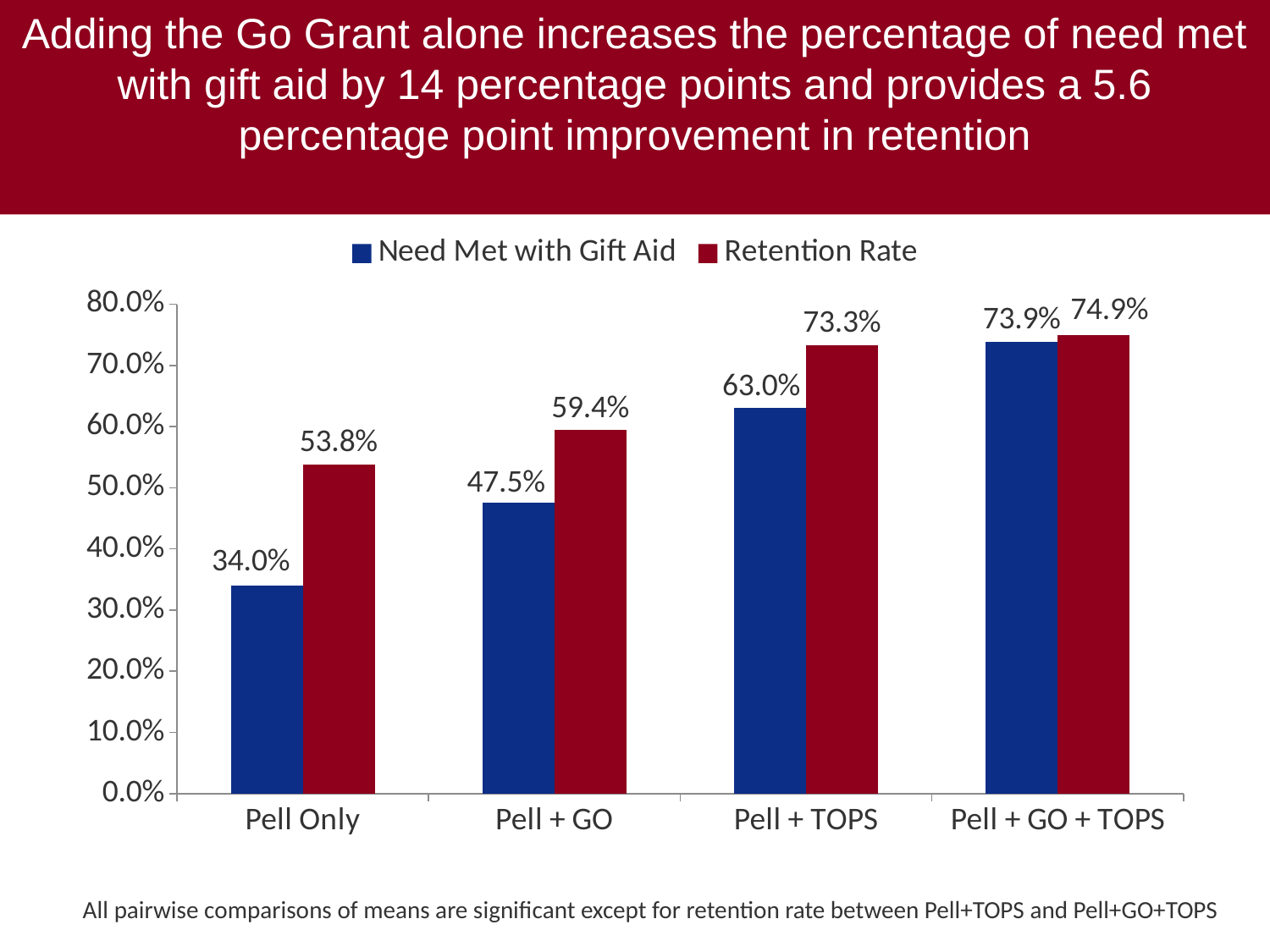
What is the Need Met with Gift Aid value for Pell Only? 34.0% How many series does the legend list? 2 What is the difference in Need Met with Gift Aid between Pell + GO and Pell Only? 13.5% What is the Need Met with Gift Aid value for Pell + TOPS? 63.0% How many categories are shown on the x axis? 4 Which category has the lowest Retention Rate? Pell Only What is the difference in Retention Rate between Pell + GO and Pell Only? 5.6% Which is larger for Pell + TOPS: Need Met with Gift Aid or Retention Rate? Retention Rate Which category has the highest Need Met with Gift Aid value? Pell + GO + TOPS What is the Retention Rate for Pell + GO + TOPS? 74.9% What kind of chart is shown on the slide? Bar chart What is the Retention Rate for Pell + GO? 59.4%